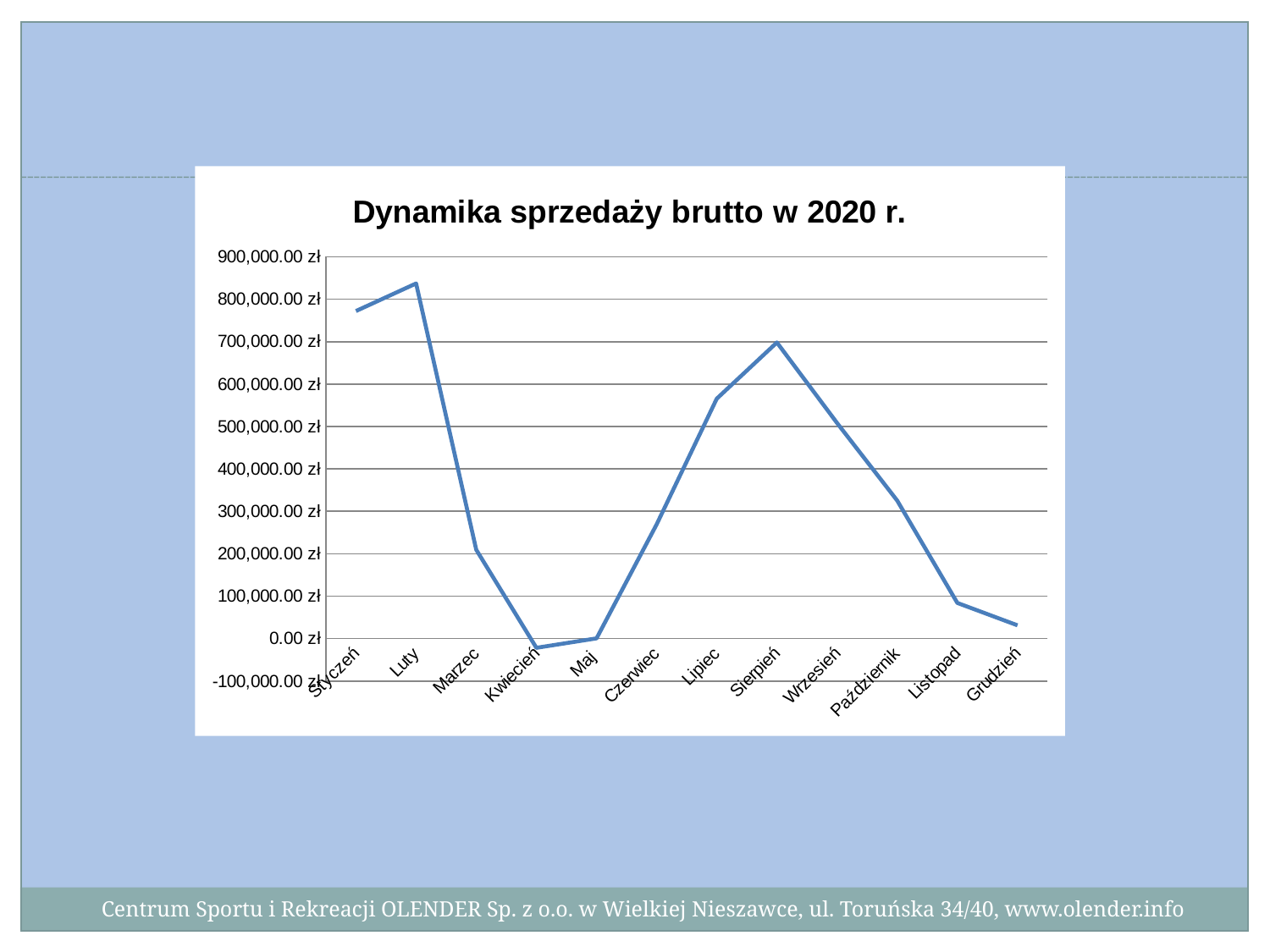
Do the values rise or fall from Luty to Kwiecień? fall Which is larger, the value for Lipiec or the value for Październik? Lipiec Is the value for Marzec greater or less than 300,000.00 zł? less Which month has the highest value? Luty Which month has the lowest value? Kwiecień What is the title of the chart? Dynamika sprzedaży brutto w 2020 r. Is the value for Listopad greater or less than 200,000.00 zł? less Is the value for Sierpień greater or less than 600,000.00 zł? greater Do the values rise or fall from Maj to Sierpień? rise How many months are plotted along the x axis? 12 What kind of chart is shown on the slide? line chart